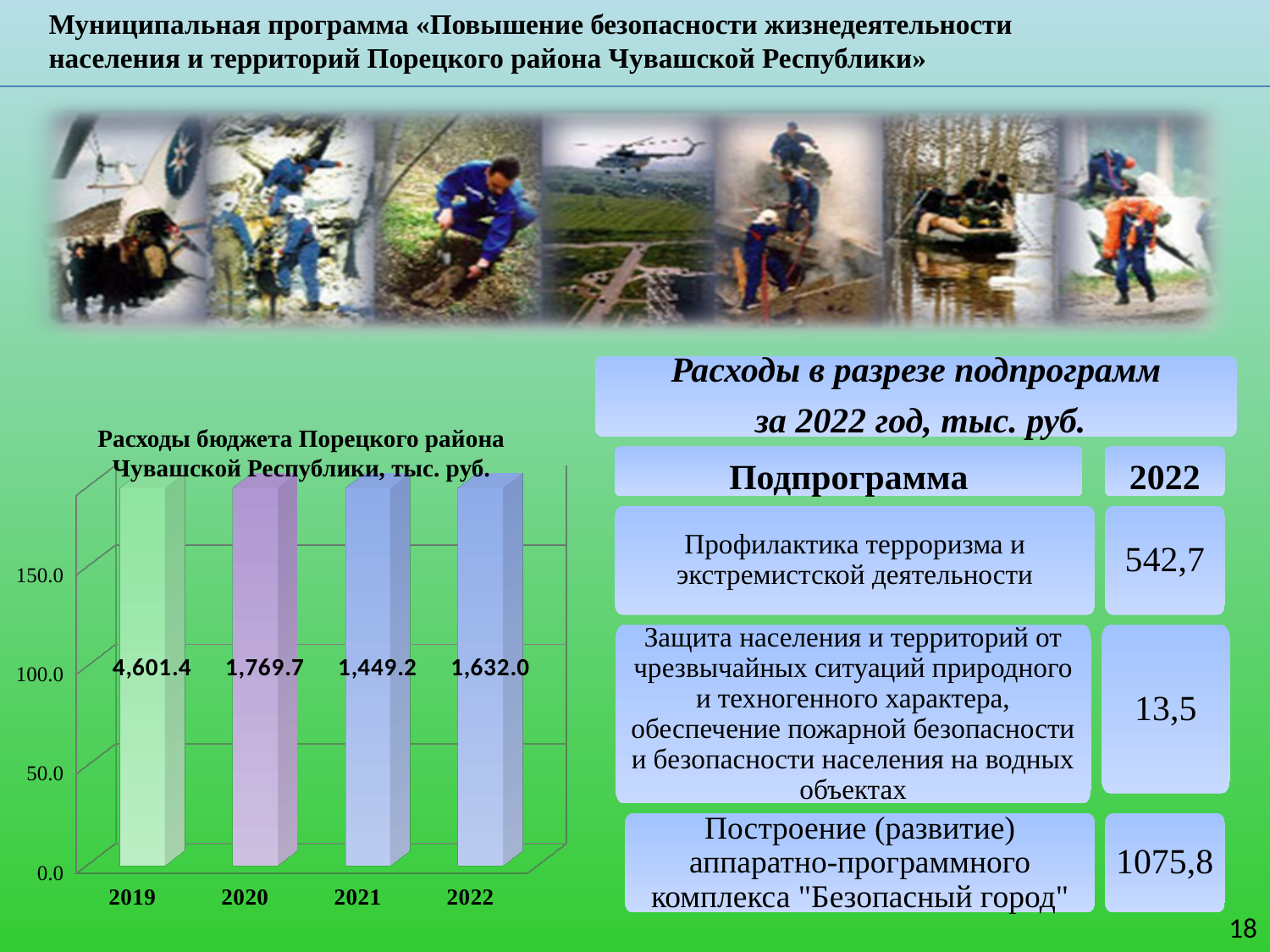
How many years are shown in the bar chart? 4 What is the value for 2021 in the bar chart? 1,449.2 Which year has the lowest value in the bar chart? 2021 What kind of chart is used to show the budget expenditures? bar chart Which year has the highest value in the bar chart? 2019 What is the value for 2020 in the bar chart? 1,769.7 What is the value for 2022 in the bar chart? 1,632.0 What is the value for 2019 in the chart "Расходы бюджета Порецкого района Чувашской Республики, тыс. руб."? 4,601.4 Which is larger in the bar chart, the value for 2020 or the value for 2022? 2020 What is the difference between the values for 2022 and 2021 in the bar chart? 182.8 What is the difference between the values for 2020 and 2021 in the bar chart? 320.5 Do the values in the bar chart rise or fall from 2019 to 2021? fall